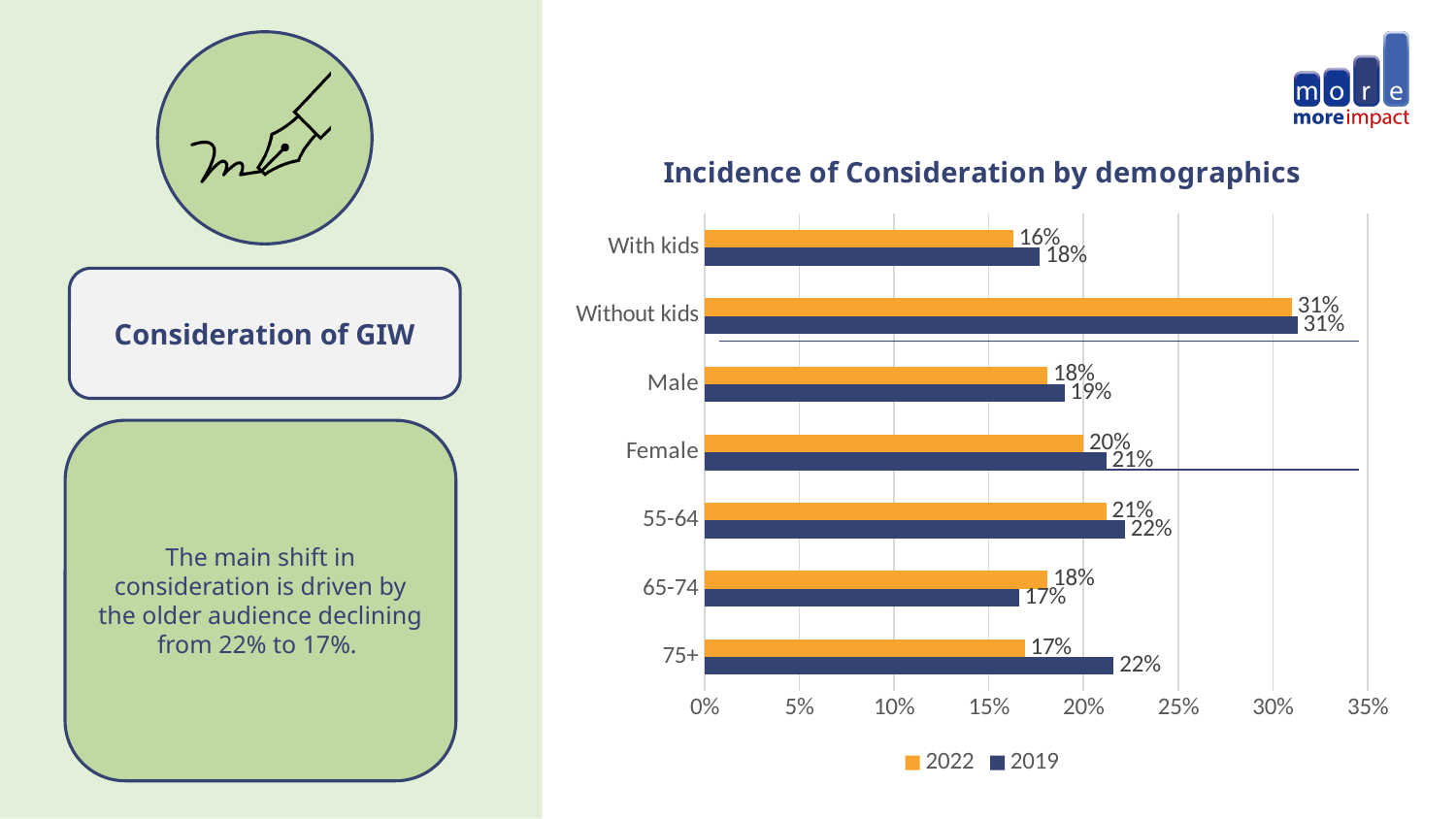
Which category has the lowest 2022 value? With kids What kind of chart is shown? bar chart What is the 2022 value for Female? 20% Which category has the highest 2022 value? Without kids How many series does the legend list? 2 How many categories are shown on the chart? 7 What is the difference between the 2019 and 2022 values for 75+? 5% Which is larger for 65-74: the 2022 value or the 2019 value? 2022 What is the 2019 value for 75+? 22% Is the 2019 value for Without kids greater or less than 30%? greater What is the 2022 value for With kids? 16% What is the title of the chart? Incidence of Consideration by demographics